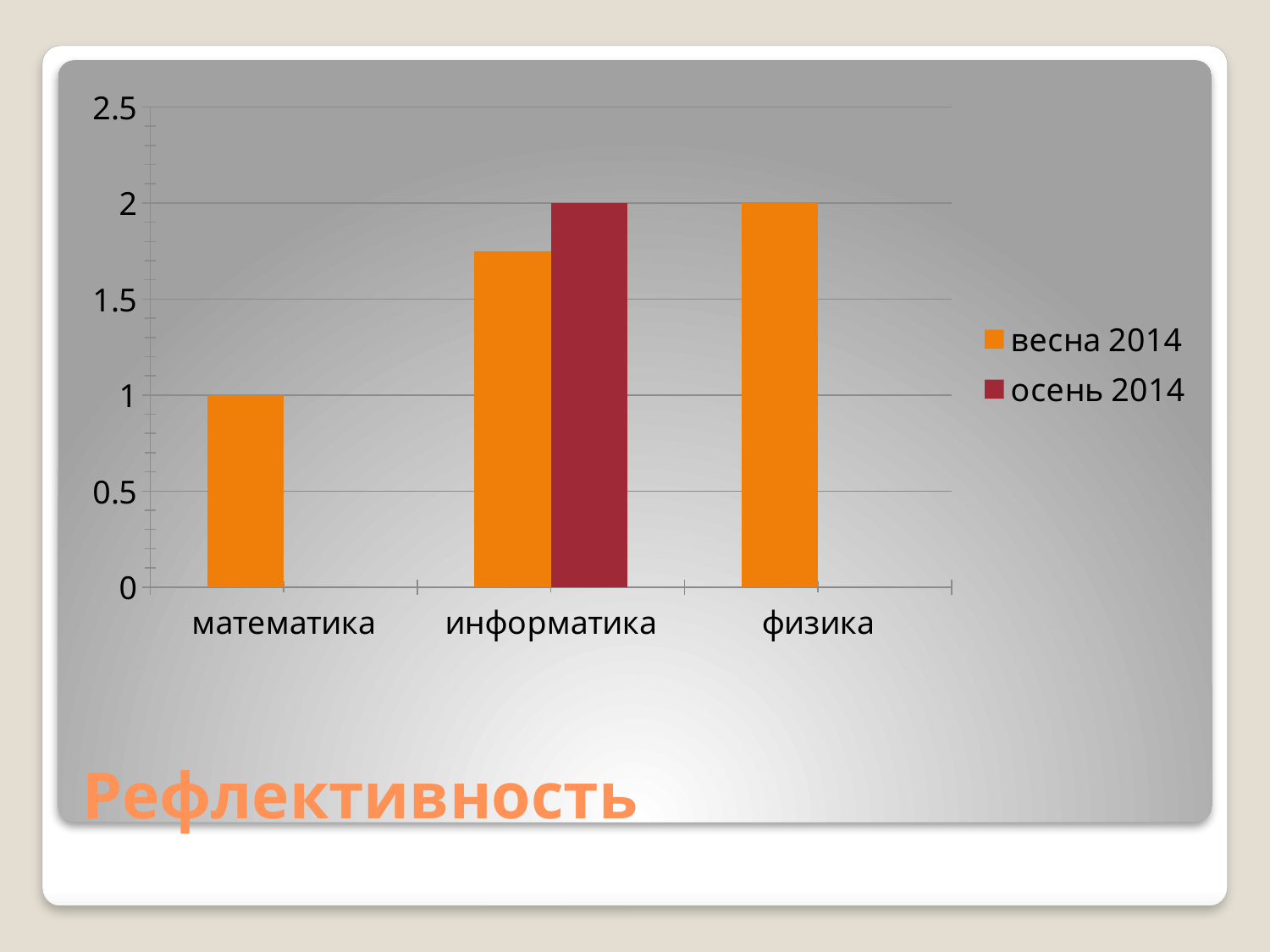
For информатика, which series has the larger value: весна 2014 or осень 2014? осень 2014 Which category has the lowest value in the весна 2014 series? математика What is the value for математика in the весна 2014 series? 1 What is the value for информатика in the осень 2014 series? 2 What is the title of the chart? Рефлективность How many categories are shown on the x axis? 3 In the весна 2014 series, which is larger: математика or физика? физика Is the value for информатика in the весна 2014 series greater or less than 1.5? greater What is the difference between the весна 2014 values for физика and математика? 1 What kind of chart is shown on the slide? bar chart What is the value for физика in the весна 2014 series? 2 How many series does the legend list? 2